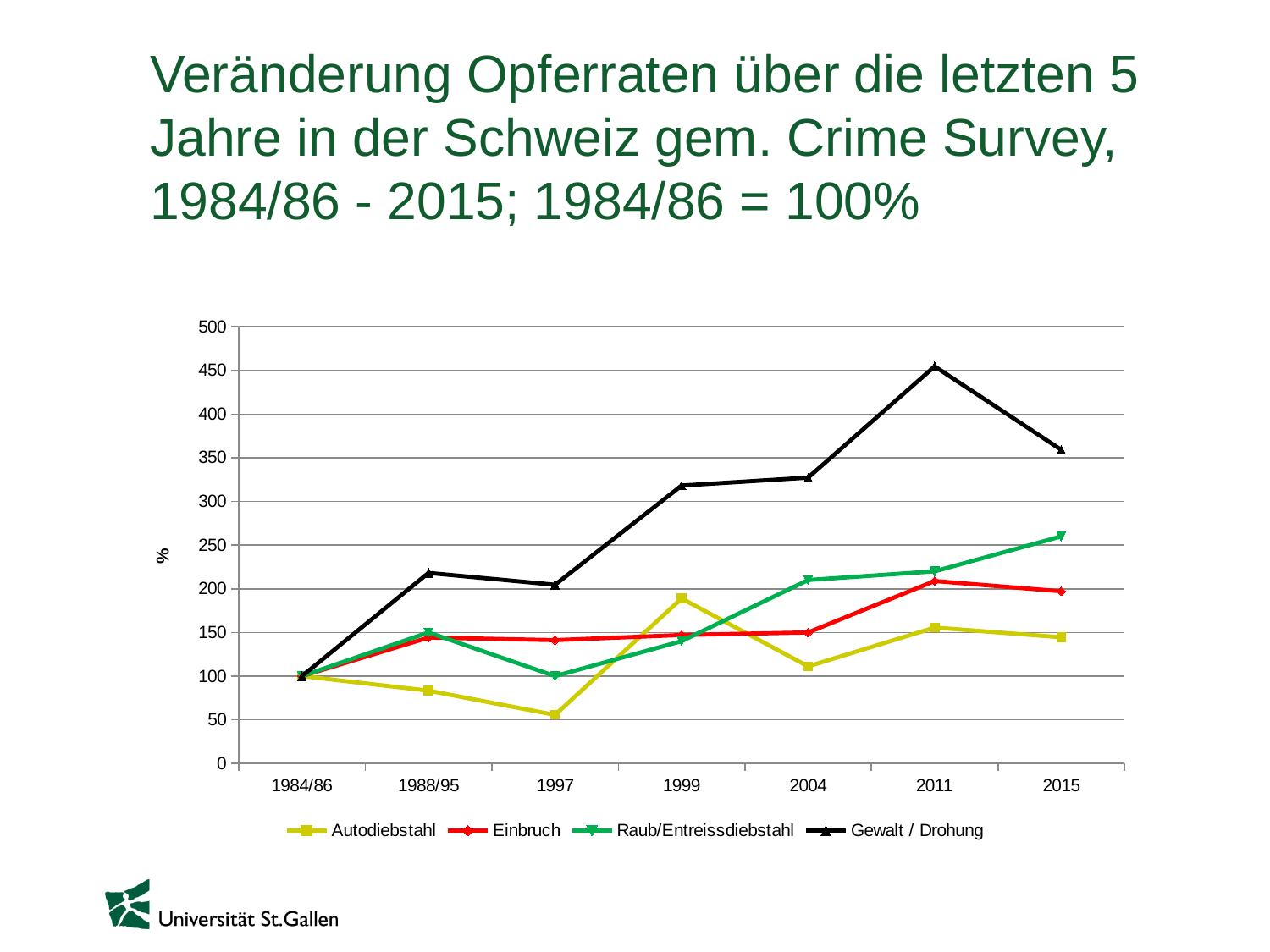
Does the value for Gewalt / Drohung rise or fall from 2011 to 2015? fall What is the label on the y axis? % Which series has the highest value in 2011? Gewalt / Drohung Is the value for Autodiebstahl in 1997 greater or less than 100? less How many series does the legend list? 4 In 2015, which is higher: Raub/Entreissdiebstahl or Einbruch? Raub/Entreissdiebstahl How many time points are shown on the x axis? 7 Which series has the lowest value in 2004? Autodiebstahl What is the value for Gewalt / Drohung in 1984/86? 100 Is the value for Einbruch in 2004 greater or less than 200? less Is the value for Gewalt / Drohung in 2011 greater or less than 400? greater What kind of chart is shown on the slide? line chart